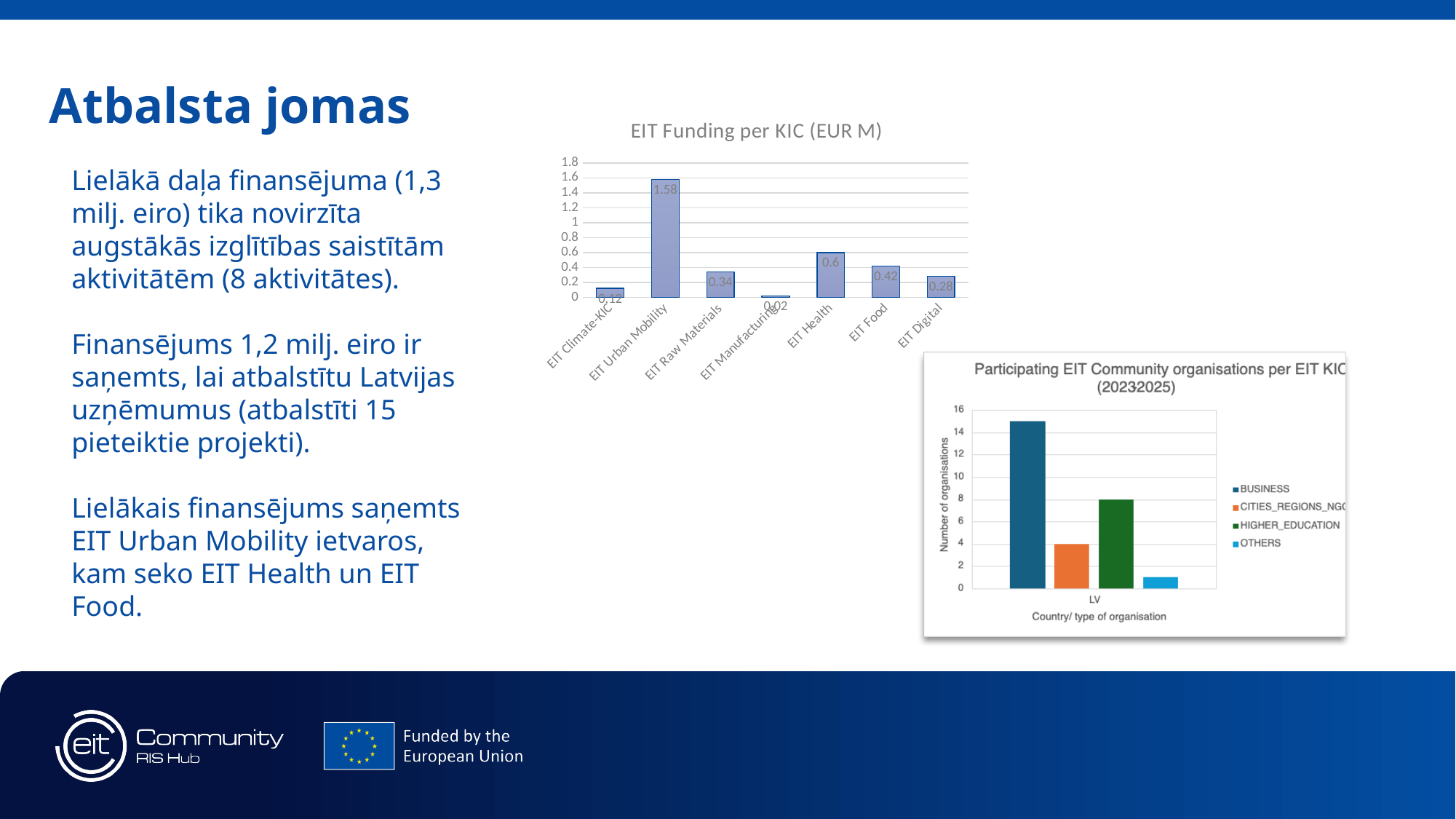
In the 'Participating EIT Community organisations per EIT KIC' chart, is the value for BUSINESS greater or less than 14? greater In the 'EIT Funding per KIC (EUR M)' chart, what is the value for EIT Health? 0.6 How many KICs are shown in the 'EIT Funding per KIC (EUR M)' chart? 7 In the 'Participating EIT Community organisations per EIT KIC' chart, what is the value for HIGHER_EDUCATION? 8 In the 'EIT Funding per KIC (EUR M)' chart, which KIC has the lowest funding? EIT Manufacturing In the 'EIT Funding per KIC (EUR M)' chart, which KIC has the highest funding? EIT Urban Mobility In the 'EIT Funding per KIC (EUR M)' chart, what is the difference between EIT Urban Mobility and EIT Health? 0.98 In the 'EIT Funding per KIC (EUR M)' chart, which is larger, EIT Raw Materials or EIT Digital? EIT Raw Materials In the 'Participating EIT Community organisations per EIT KIC' chart, how many series does the legend list? 4 In the 'EIT Funding per KIC (EUR M)' chart, what is the value for EIT Food? 0.42 In the 'EIT Funding per KIC (EUR M)' chart, what is the value for EIT Urban Mobility? 1.58 What type of chart is the 'EIT Funding per KIC (EUR M)' chart? Bar chart